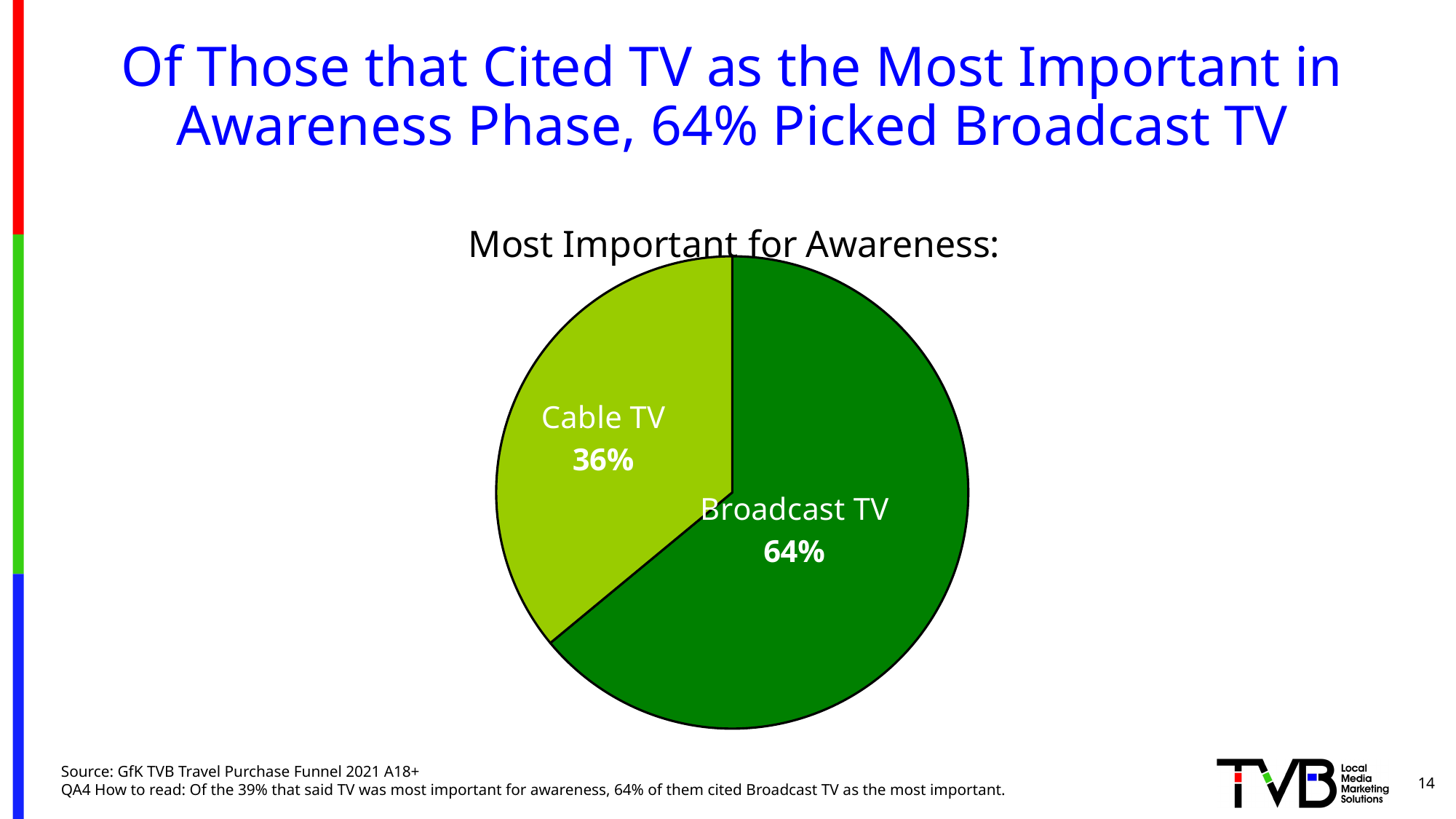
What percentage of the pie is Broadcast TV? 64% How many slices does the pie chart have? 2 Which slice of the pie is the smallest? Cable TV What kind of chart is shown on the slide? Pie chart What percentage of the pie is Cable TV? 36% Which slice of the pie is the largest? Broadcast TV Which slice is shown in the darker green colour? Broadcast TV What is the difference in percentage points between Broadcast TV and Cable TV? 28 What is the title of the chart? Most Important for Awareness: What share of the pie does Cable TV represent? 36% Which is larger, the Cable TV slice or the Broadcast TV slice? Broadcast TV